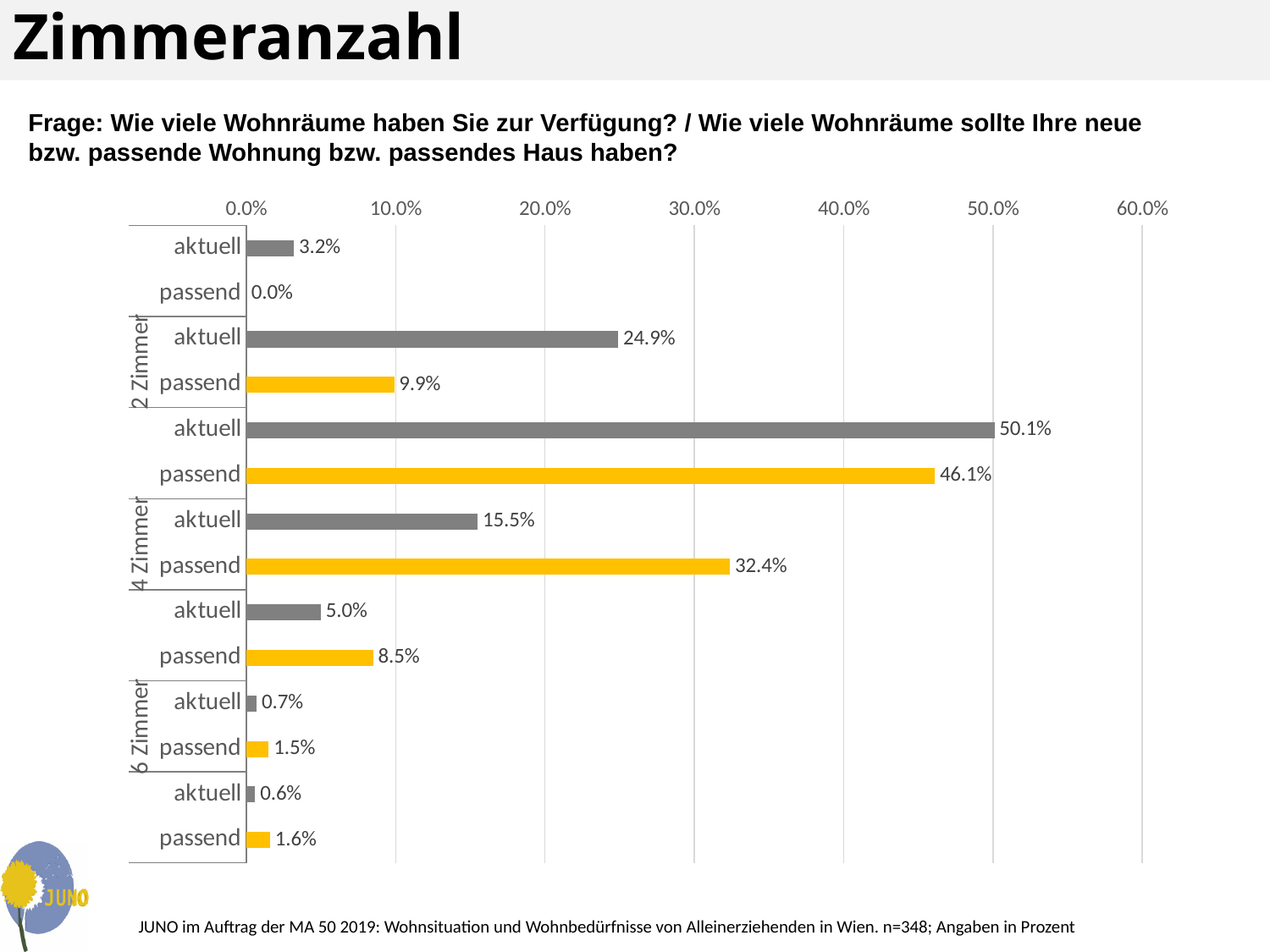
What is the highest value shown on the horizontal axis of the chart? 60.0% Is the value of the 'aktuell' bar in the '2 Zimmer' group greater or less than 20.0%? greater What is the value of the topmost 'aktuell' bar in the chart? 3.2% What is the value of the 'aktuell' bar in the '2 Zimmer' group? 24.9% In the '4 Zimmer' group, which bar is larger, 'aktuell' or 'passend'? passend What is the highest value shown in the chart? 50.1% In the '2 Zimmer' group, what is the difference between the 'aktuell' and 'passend' values? 15.0% What is the value of the 'aktuell' bar in the '6 Zimmer' group? 0.7% What is the value of the 'passend' bar in the '2 Zimmer' group? 9.9% In the '4 Zimmer' group, what is the difference between the 'passend' and 'aktuell' values? 16.9% What is the value of the 'passend' bar in the '4 Zimmer' group? 32.4% What type of chart is shown on the slide? bar chart